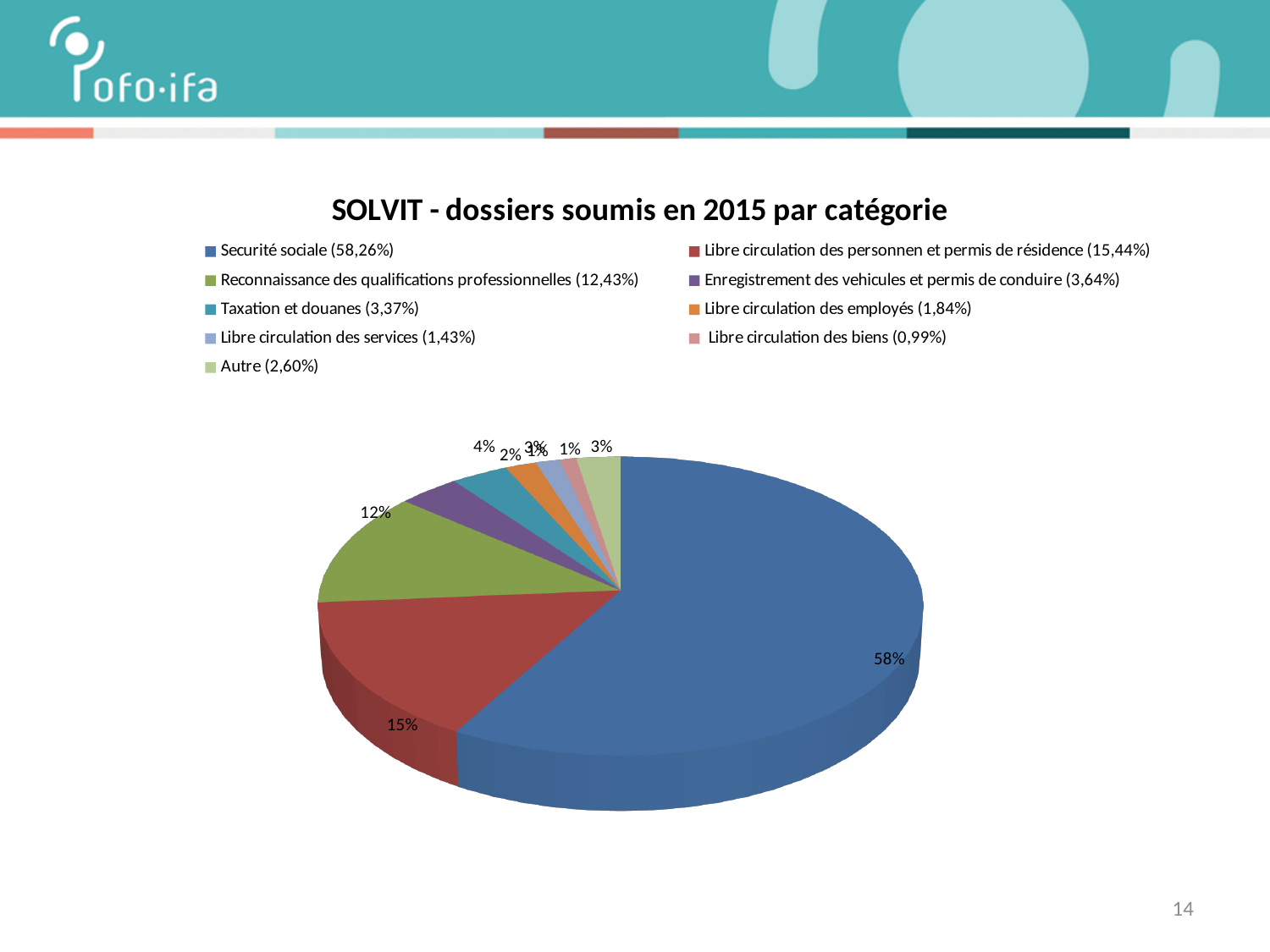
Which category has the largest share of the pie? Securité sociale What share does the legend give for Securité sociale? 58,26% Which category has the smallest share of the pie? Libre circulation des biens What data label is printed on the largest slice of the pie? 58% What type of chart is shown on the slide? pie chart Which has the larger share: Enregistrement des vehicules et permis de conduire or Libre circulation des employés? Enregistrement des vehicules et permis de conduire What share does the legend give for Autre? 2,60% What share does the legend give for Reconnaissance des qualifications professionnelles? 12,43% How many categories does the legend list? 9 What is the difference in percentage points between the shares of Securité sociale and Libre circulation des personnen et permis de résidence, using the legend values? 42,82 What is the title of the chart? SOLVIT - dossiers soumis en 2015 par catégorie What share does the legend give for Taxation et douanes? 3,37%